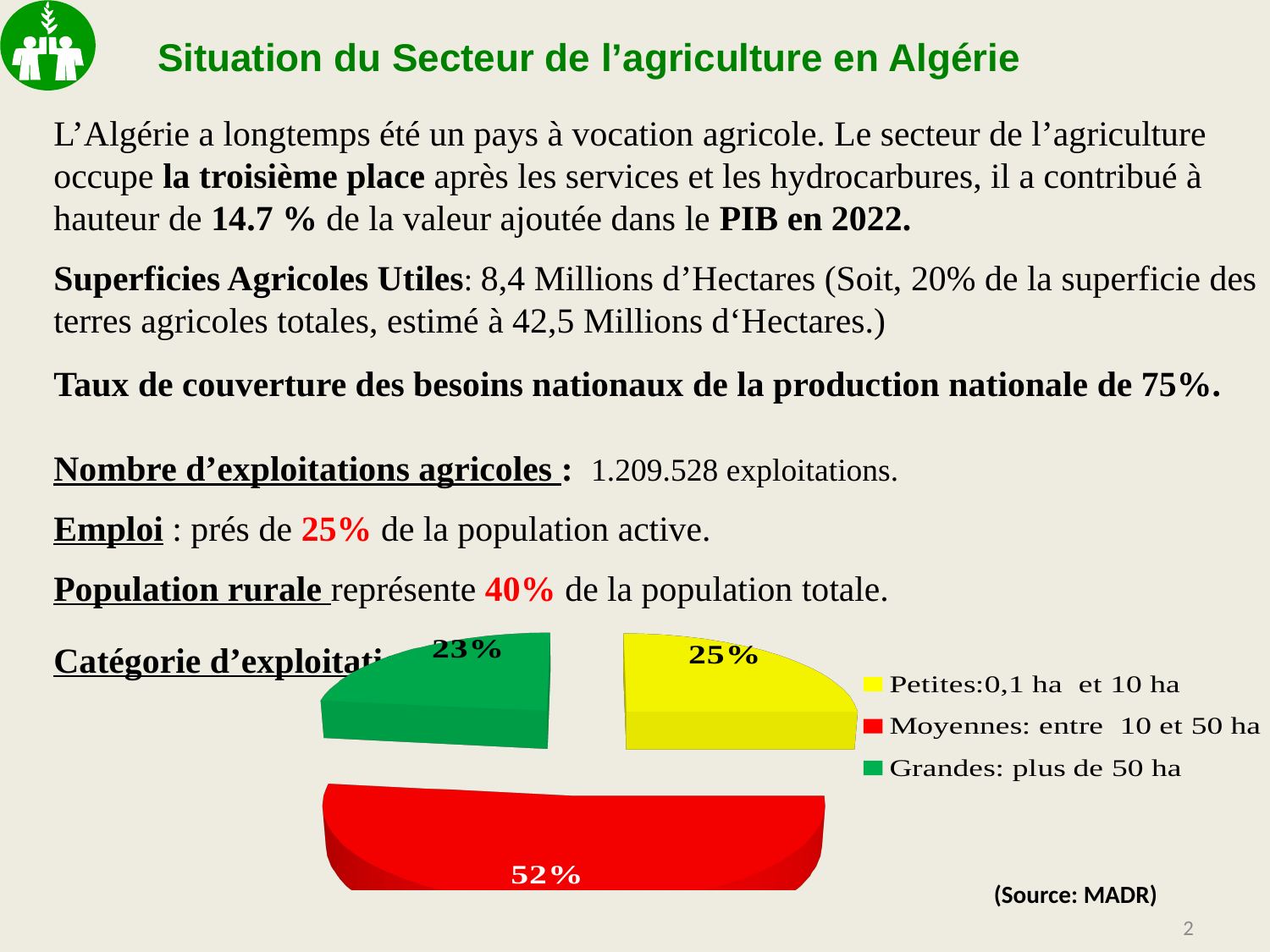
Which category has the smallest slice in the pie chart? Grandes: plus de 50 ha What colour is the 'Moyennes: entre 10 et 50 ha' slice in the pie chart? red What share of the pie chart does the 'Moyennes: entre 10 et 50 ha' category represent? 52% How many entries does the legend of the pie chart list? 3 What is the difference in percentage points between the 'Moyennes' slice and the 'Petites' slice? 27 Which category has the largest slice in the pie chart? Moyennes: entre 10 et 50 ha What share of the pie chart does the 'Grandes: plus de 50 ha' category represent? 23% What colour is the 'Grandes: plus de 50 ha' slice in the pie chart? green What share of the pie chart does the 'Petites:0,1 ha et 10 ha' category represent? 25% Which slice is larger in the pie chart: 'Petites' or 'Grandes'? Petites:0,1 ha et 10 ha How many slices does the pie chart have? 3 What kind of chart is shown on the slide? pie chart